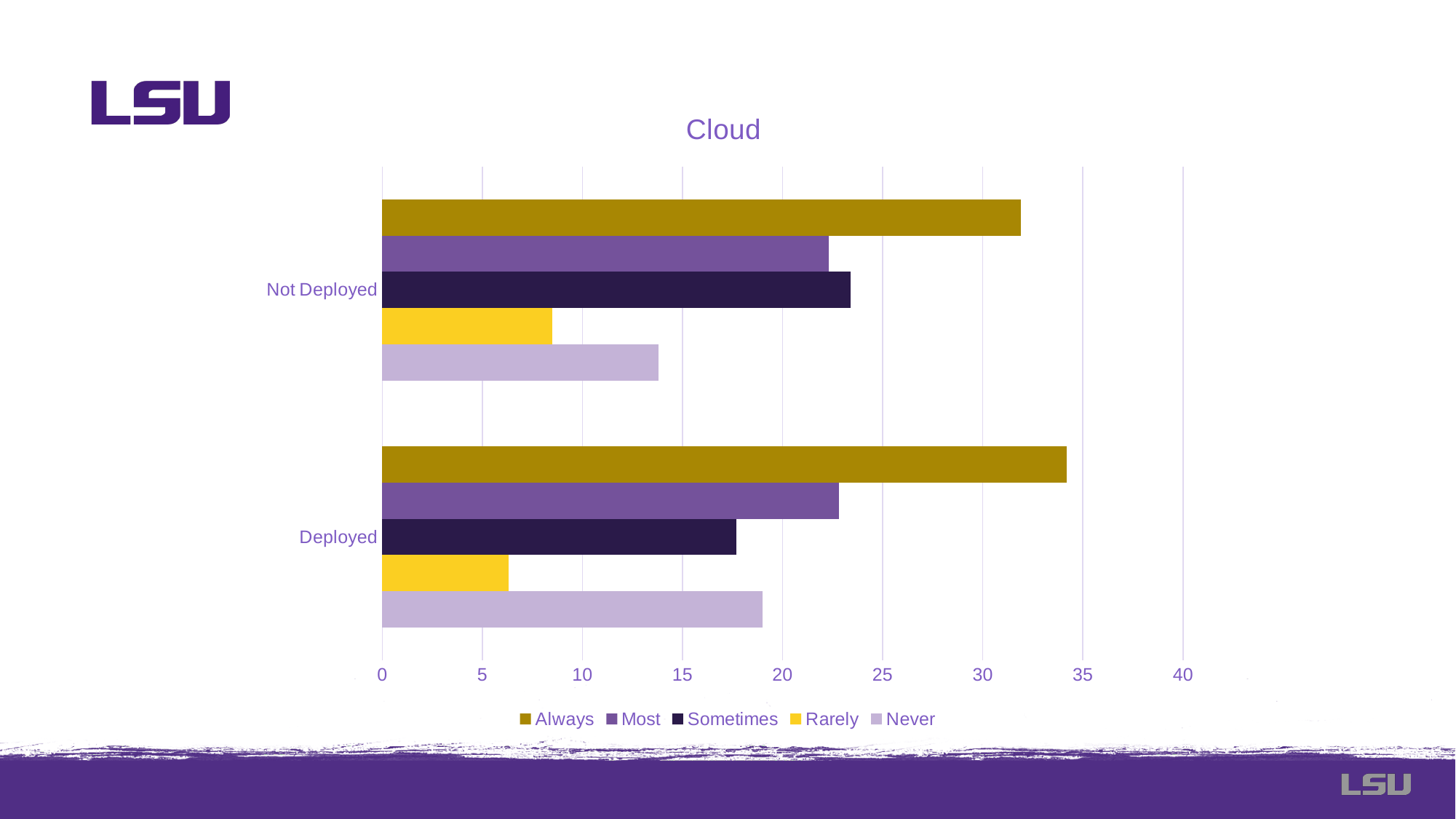
Is the value for Sometimes in the Not Deployed category larger for Not Deployed or for Deployed? Not Deployed Is the value for Never larger for Deployed or for Not Deployed? Deployed How many series does the legend list? 5 Is the value for Never in the Not Deployed category greater or less than 15? less Which series has the lowest value for Deployed? Rarely Is the value for Always in the Deployed category greater or less than 30? greater How many categories are shown on the vertical axis? 2 Is the value for Rarely in the Deployed category greater or less than 10? less What is the title of the chart? Cloud Which series has the highest value for Deployed? Always Which series has the lowest value for Not Deployed? Rarely What kind of chart is shown on the slide? bar chart